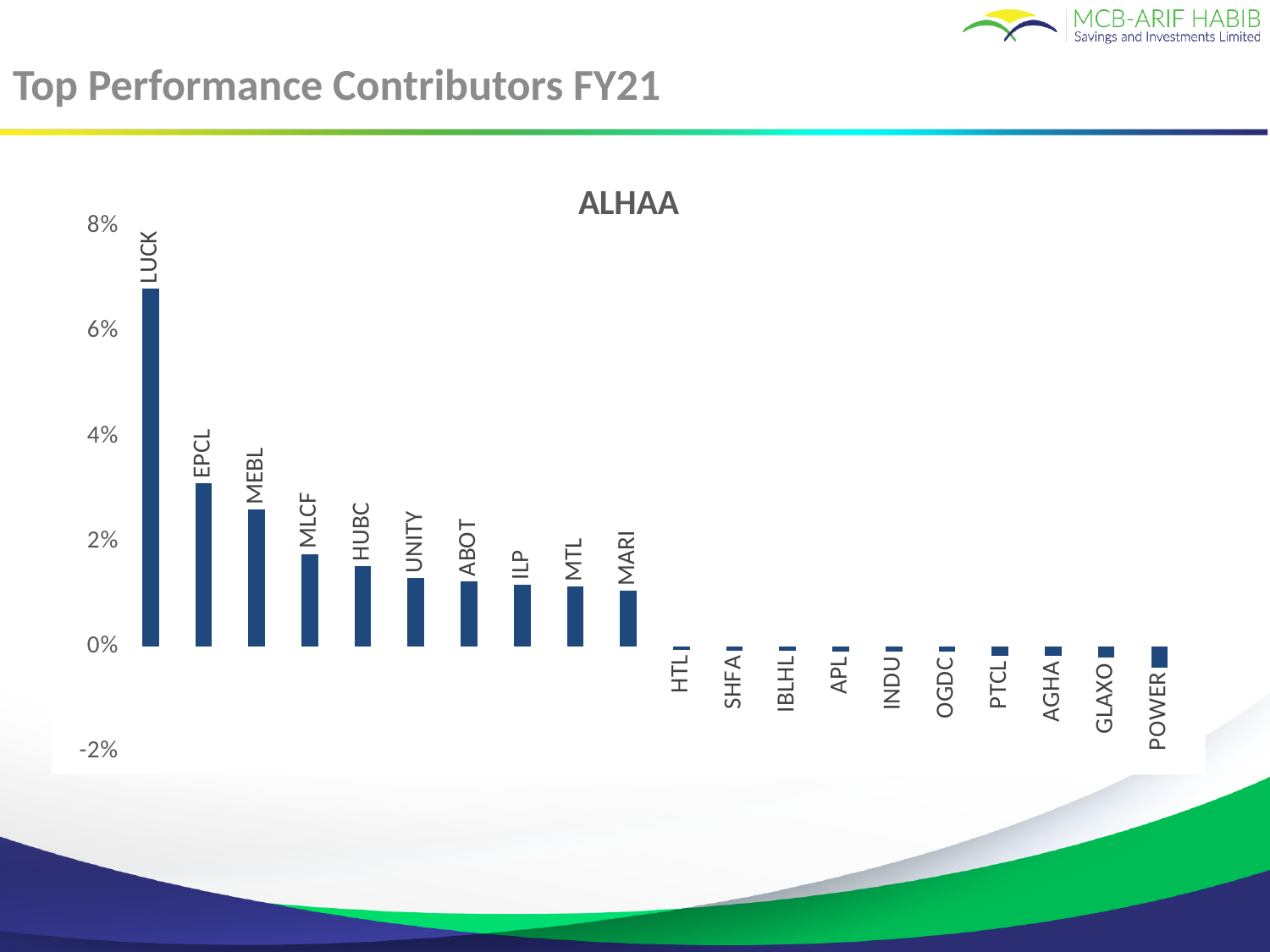
Is the value for MARI greater or less than 2%? less Which is larger, the value for EPCL or the value for MEBL? EPCL Is the value for LUCK greater or less than 6%? greater Do the values rise or fall moving from left to right along the x axis? fall Is the value for EPCL greater or less than 2%? greater What is the title of the chart? ALHAA What kind of chart is shown on the slide? Bar chart Which category has the highest value? LUCK How many categories have a negative value? 10 How many categories are plotted on the chart? 20 Which category has the lowest value? POWER